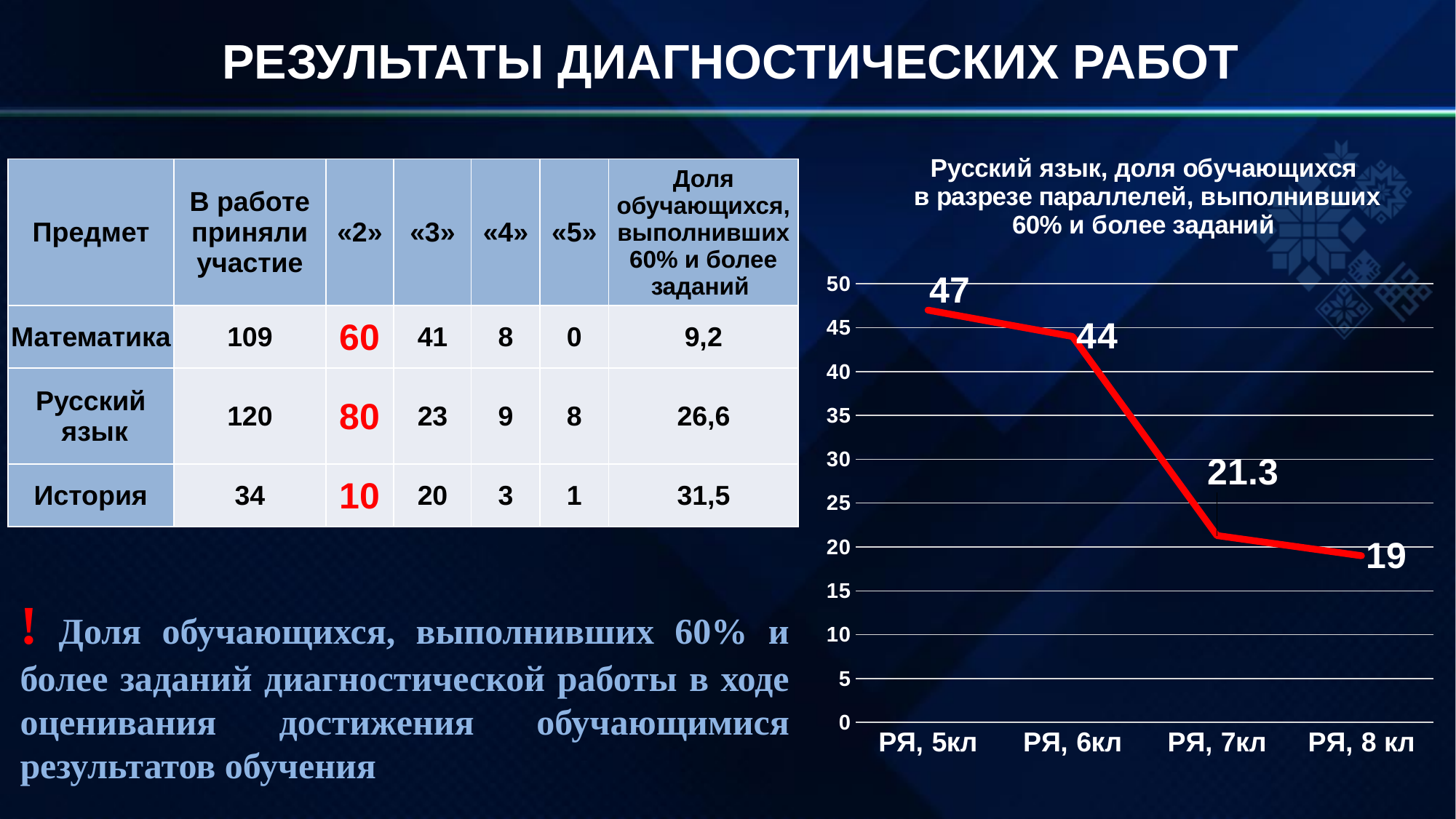
What is the value for РЯ, 7кл? 21.3 What is the difference between the values for РЯ, 5кл and РЯ, 6кл? 3 How many categories are plotted on the chart? 4 What is the value for РЯ, 8 кл? 19 What is the value for РЯ, 5кл? 47 Do the values rise or fall from РЯ, 5кл to РЯ, 8 кл? fall What is the difference between the values for РЯ, 6кл and РЯ, 7кл? 22.7 Which category has the lowest value? РЯ, 8 кл Which is larger, the value for РЯ, 6кл or the value for РЯ, 8 кл? РЯ, 6кл Which category has the highest value? РЯ, 5кл Is the value for РЯ, 7кл greater or less than 25? less What kind of chart is shown on the slide? line chart